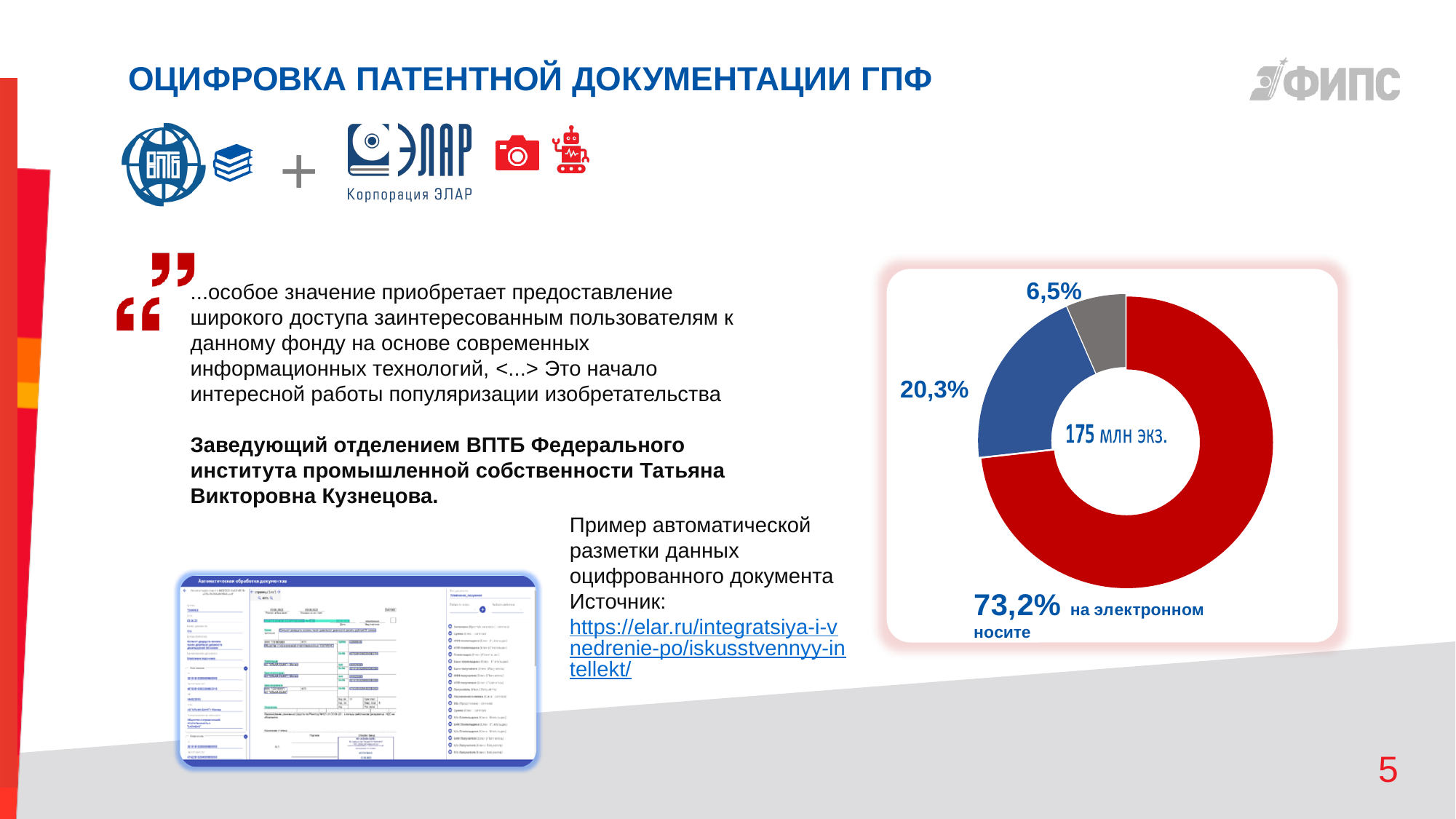
What percentage is shown for the grey slice of the donut chart? 6,5% Which is larger in the donut chart: the blue slice or the grey slice? The blue slice (20,3%) How many slices does the donut chart have? 3 Which slice of the donut chart is the smallest? The grey slice, 6,5% Which slice of the donut chart is the largest? The red slice, 73,2% (на электронном носителе) What percentage is shown for the blue slice of the donut chart? 20,3% What colour is the slice representing 73,2% in the donut chart? Red What is the difference between the red slice (73,2%) and the blue slice (20,3%)? 52,9% What share of the donut chart is labelled "на электронном носителе"? 73,2% What text is printed in the centre of the donut chart? 175 млн экз. What kind of chart is shown on the slide? Pie chart (donut) What is the difference between the blue slice (20,3%) and the grey slice (6,5%)? 13,8%